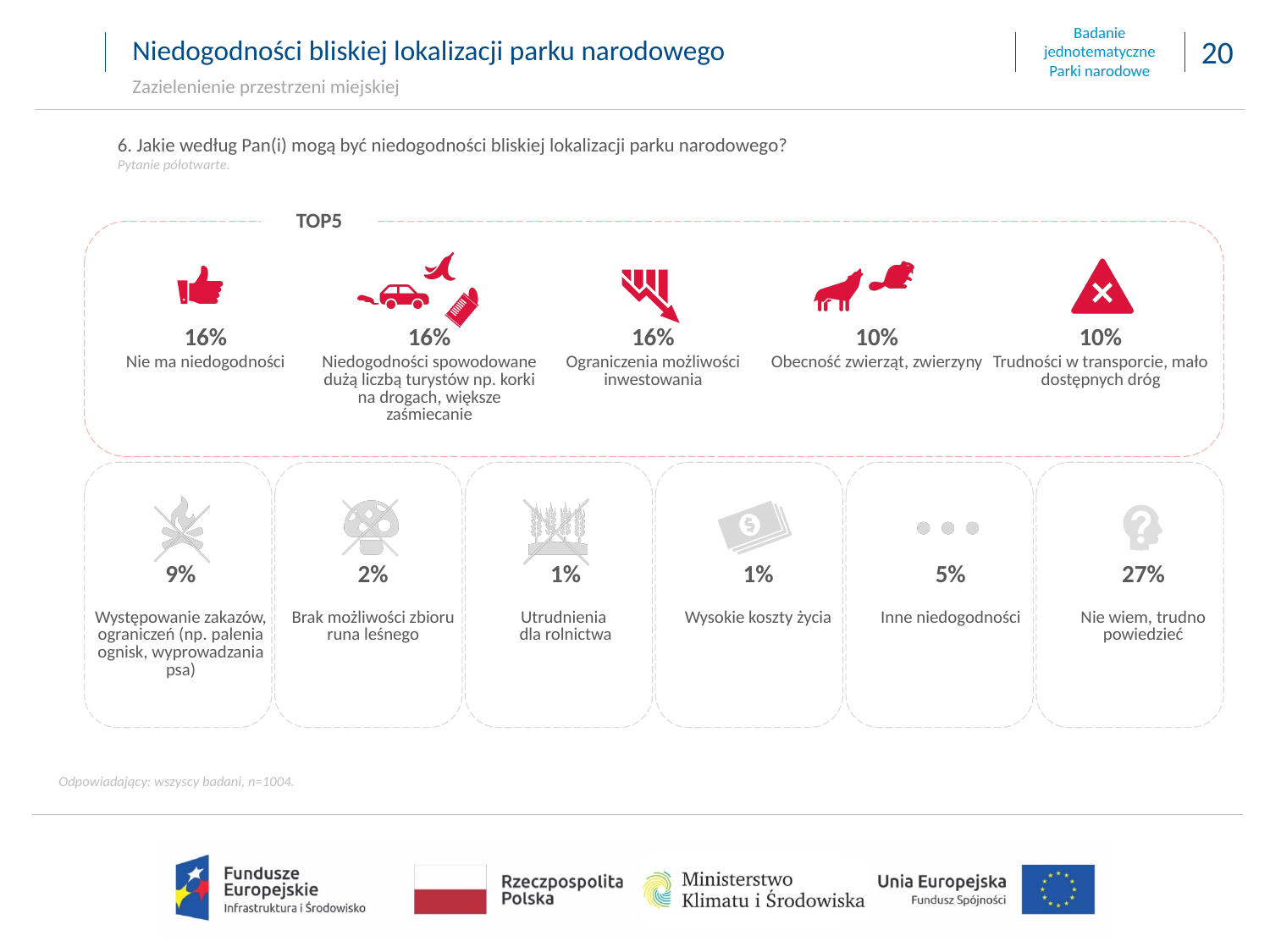
Which is larger: the percentage for "Występowanie zakazów, ograniczeń" or for "Inne niedogodności"? Występowanie zakazów, ograniczeń What percentage of respondents answered "Nie wiem, trudno powiedzieć"? 27% What percentage is shown for "Występowanie zakazów, ograniczeń (np. palenia ognisk, wyprowadzania psa)"? 9% Which two responses share the lowest percentage of 1%? Utrudnienia dla rolnictwa and Wysokie koszty życia How many responses are grouped in the TOP5 section? 5 What is the sample size (n) stated at the bottom of the slide? n=1004 Which response has the highest percentage on the slide? Nie wiem, trudno powiedzieć What percentage is shown for "Brak możliwości zbioru runa leśnego"? 2% What is the difference in percentage points between "Nie wiem, trudno powiedzieć" and "Nie ma niedogodności"? 11 percentage points What percentage is shown for "Inne niedogodności"? 5% What percentage is shown for "Obecność zwierząt, zwierzyny"? 10% How many response categories are shown on the slide in total? 11